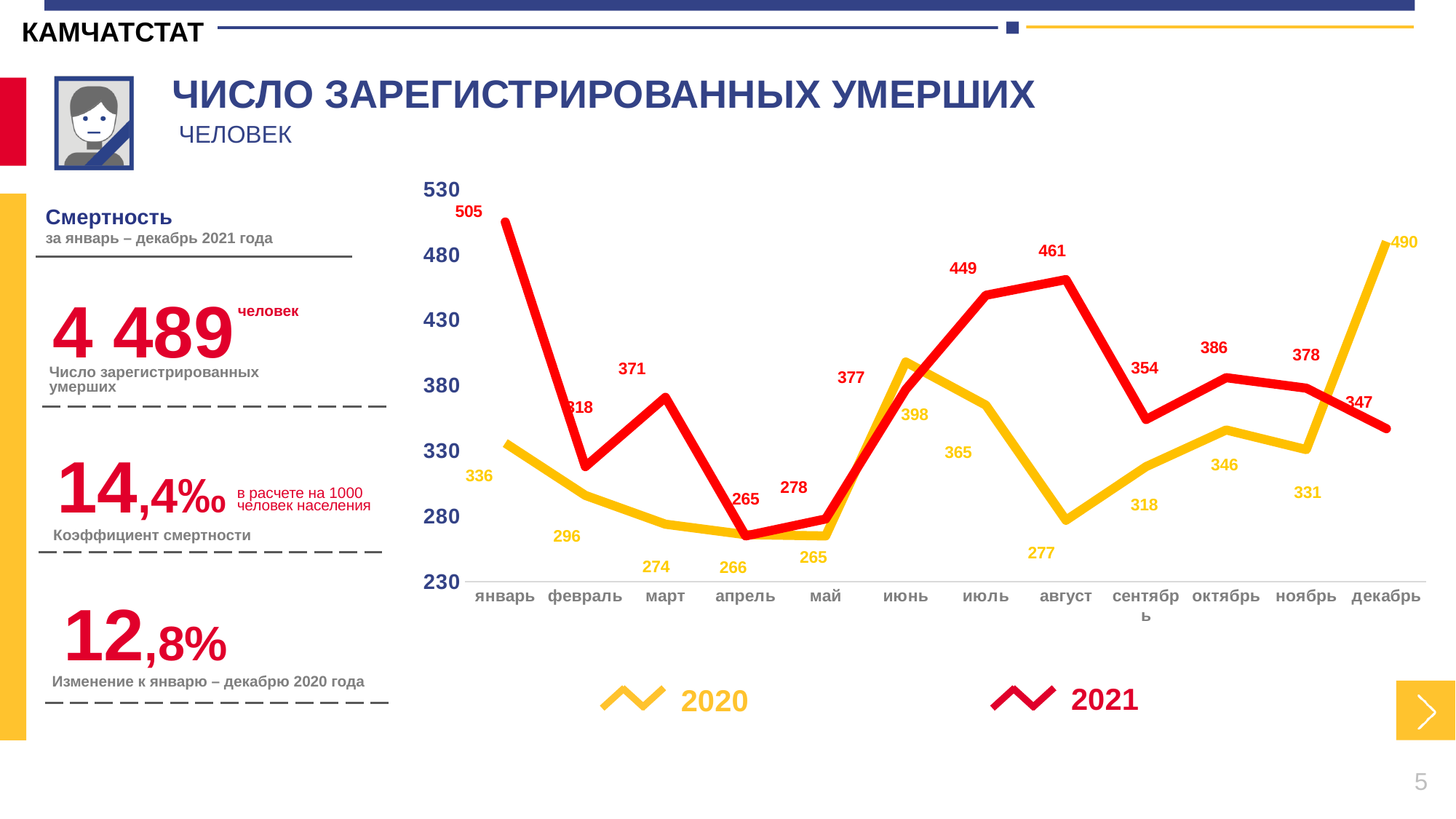
How many series does the legend list? 2 What is the value for 2020 in июнь (June)? 398 Which colour represents the 2021 series in the legend? red What is the value for 2021 in январь (January)? 505 Does the 2021 series rise or fall from январь to февраль? fall What is the value for 2020 in декабрь (December)? 490 In which month is the 2021 series highest? январь What type of chart is shown on the slide? line chart In which month is the 2020 series lowest? май What is the difference between the 2021 and 2020 values in август (August)? 184 Which series has the larger value in декабрь (December), 2020 or 2021? 2020 How many months are plotted along the x axis? 12